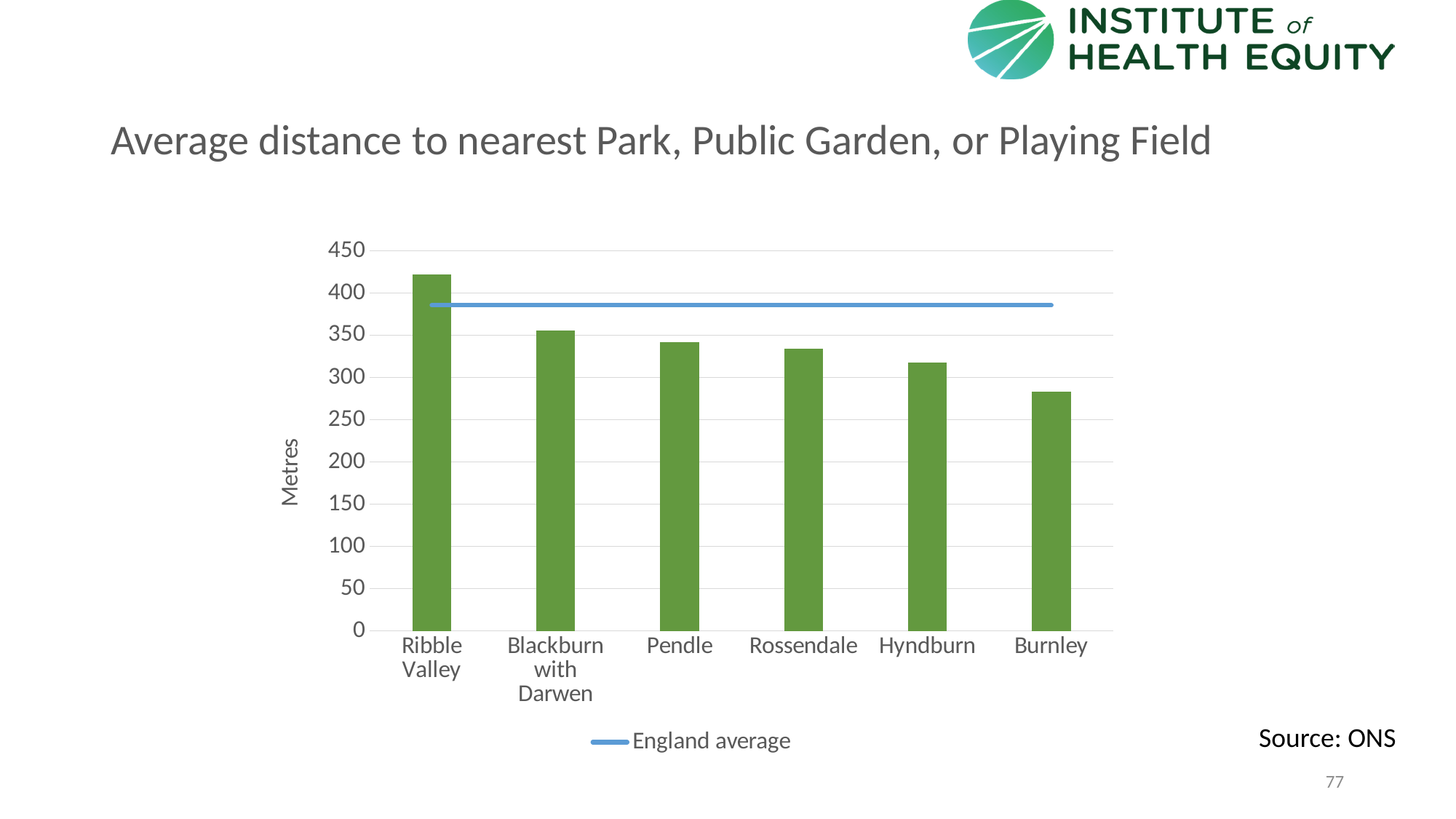
Is the value for Ribble Valley greater or less than 400? greater What is the label on the vertical axis of the chart? Metres Do the bar values rise or fall from left to right along the x axis? fall Which area has the lowest average distance to the nearest park, public garden, or playing field? Burnley Is the value for Pendle greater or less than 350? less Is the value for Burnley greater or less than 300? less How many entries does the chart legend list? 1 Which has a larger value, Pendle or Hyndburn? Pendle What kind of chart is shown on the slide? bar chart Which area has the highest average distance to the nearest park, public garden, or playing field? Ribble Valley How many local authority areas are shown on the x axis of the chart? 6